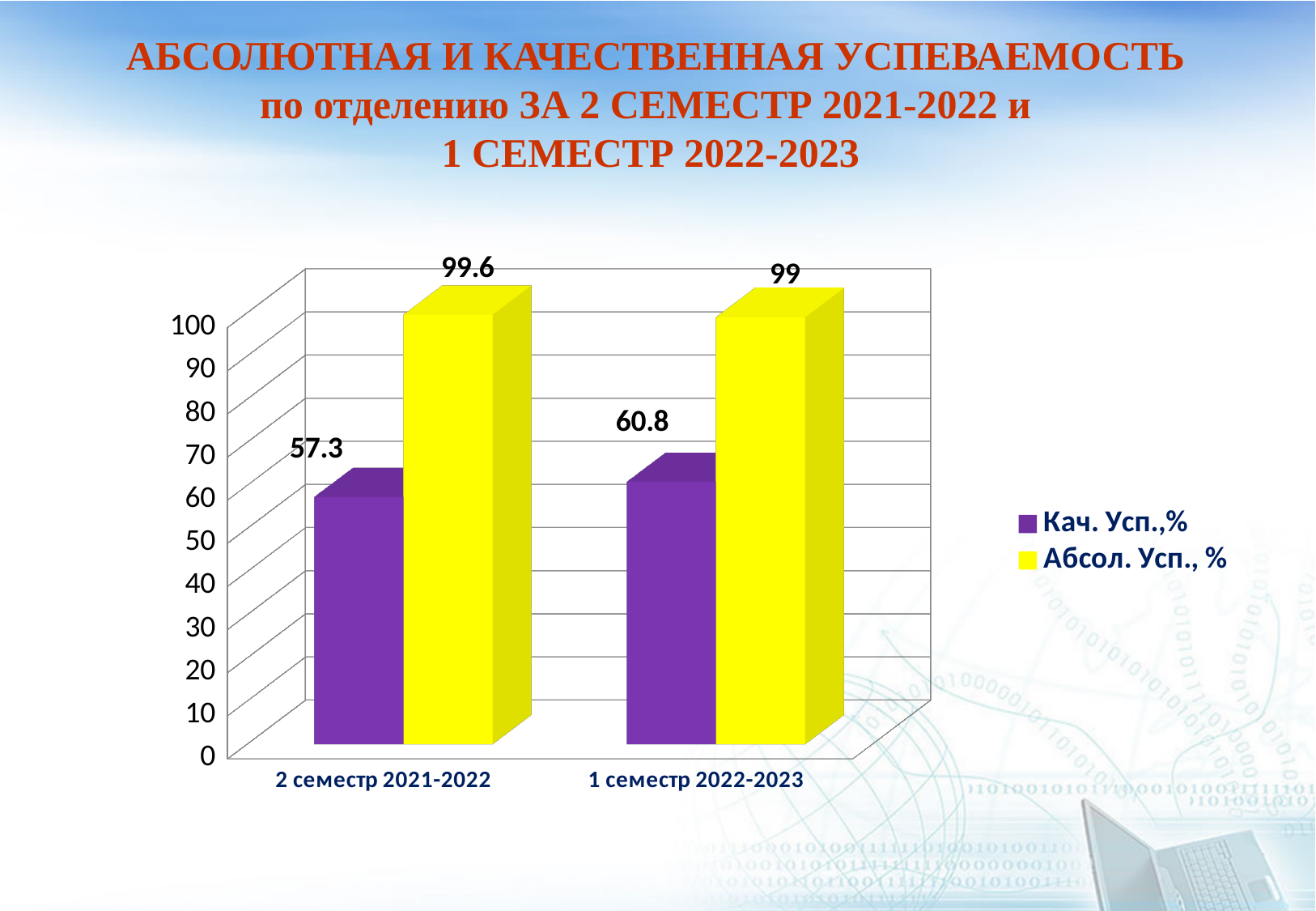
How many categories are shown on the x axis? 2 What is the difference between the Абсол. Усп., % values for 2 семестр 2021-2022 and 1 семестр 2022-2023? 0.6 What is the difference between the Кач. Усп.,% values for 1 семестр 2022-2023 and 2 семестр 2021-2022? 3.5 Which is larger: Кач. Усп.,% for 2 семестр 2021-2022 or Абсол. Усп., % for 2 семестр 2021-2022? Абсол. Усп., % for 2 семестр 2021-2022 How many series does the legend list? 2 What is the value of Кач. Усп.,% for 1 семестр 2022-2023? 60.8 What is the value of Абсол. Усп., % for 2 семестр 2021-2022? 99.6 What is the value of Кач. Усп.,% for 2 семестр 2021-2022? 57.3 What is the value of Абсол. Усп., % for 1 семестр 2022-2023? 99 Which colour represents the Абсол. Усп., % series? Yellow What kind of chart is shown on the slide? Bar chart Which category has the higher value for Кач. Усп.,%? 1 семестр 2022-2023